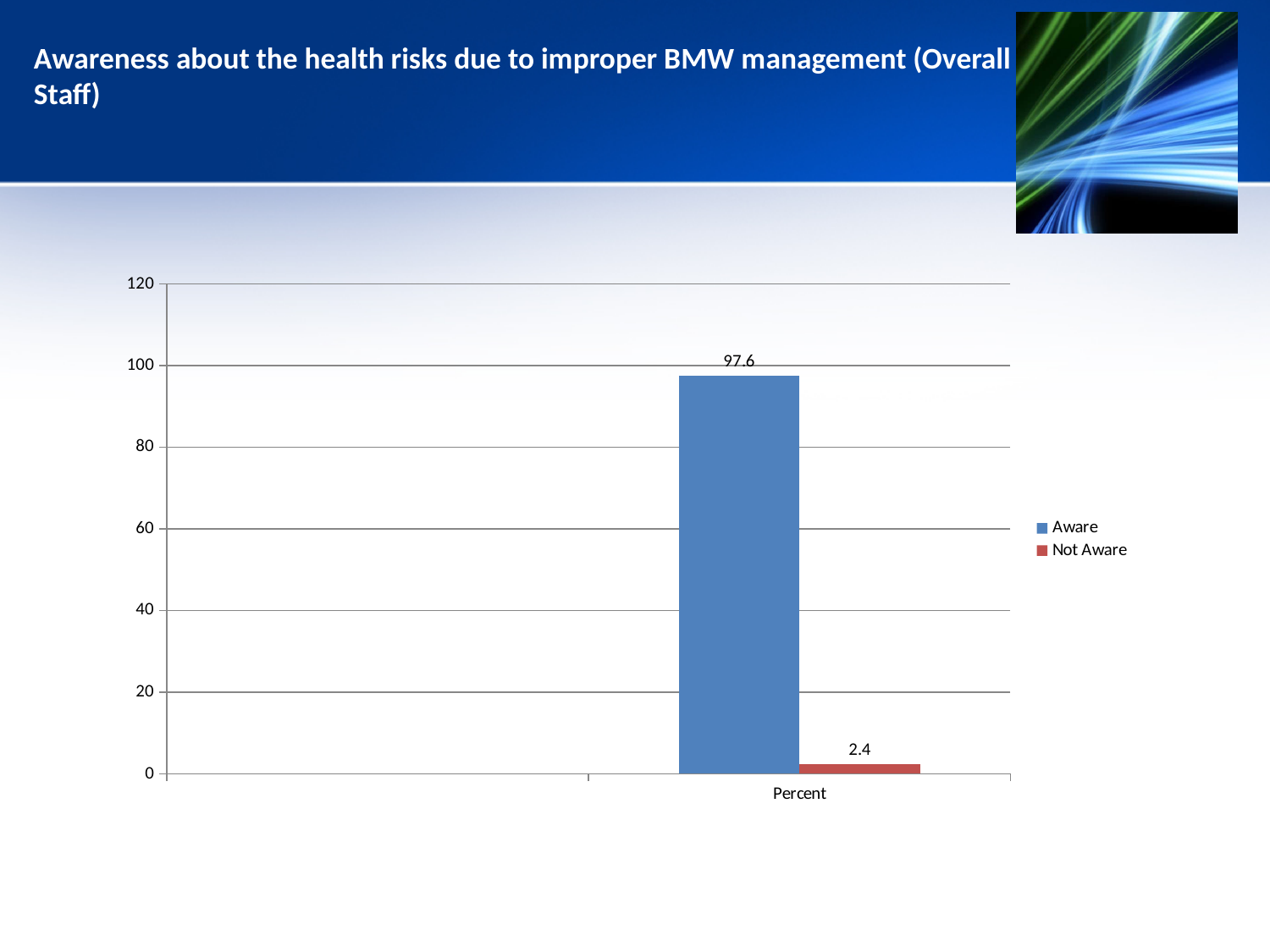
Is the value for Not Aware greater or less than 20? less What is the label on the x axis of the chart? Percent Which is larger, the value for Aware or the value for Not Aware? Aware What is the difference between the Aware and Not Aware values? 95.2 What colour is the bar for Not Aware? red Which series has the highest value? Aware How many series does the legend list? 2 Which series has the lowest value? Not Aware What is the value for Aware? 97.6 What is the value for Not Aware? 2.4 What kind of chart is shown on the slide? bar chart Is the value for Aware greater or less than 80? greater